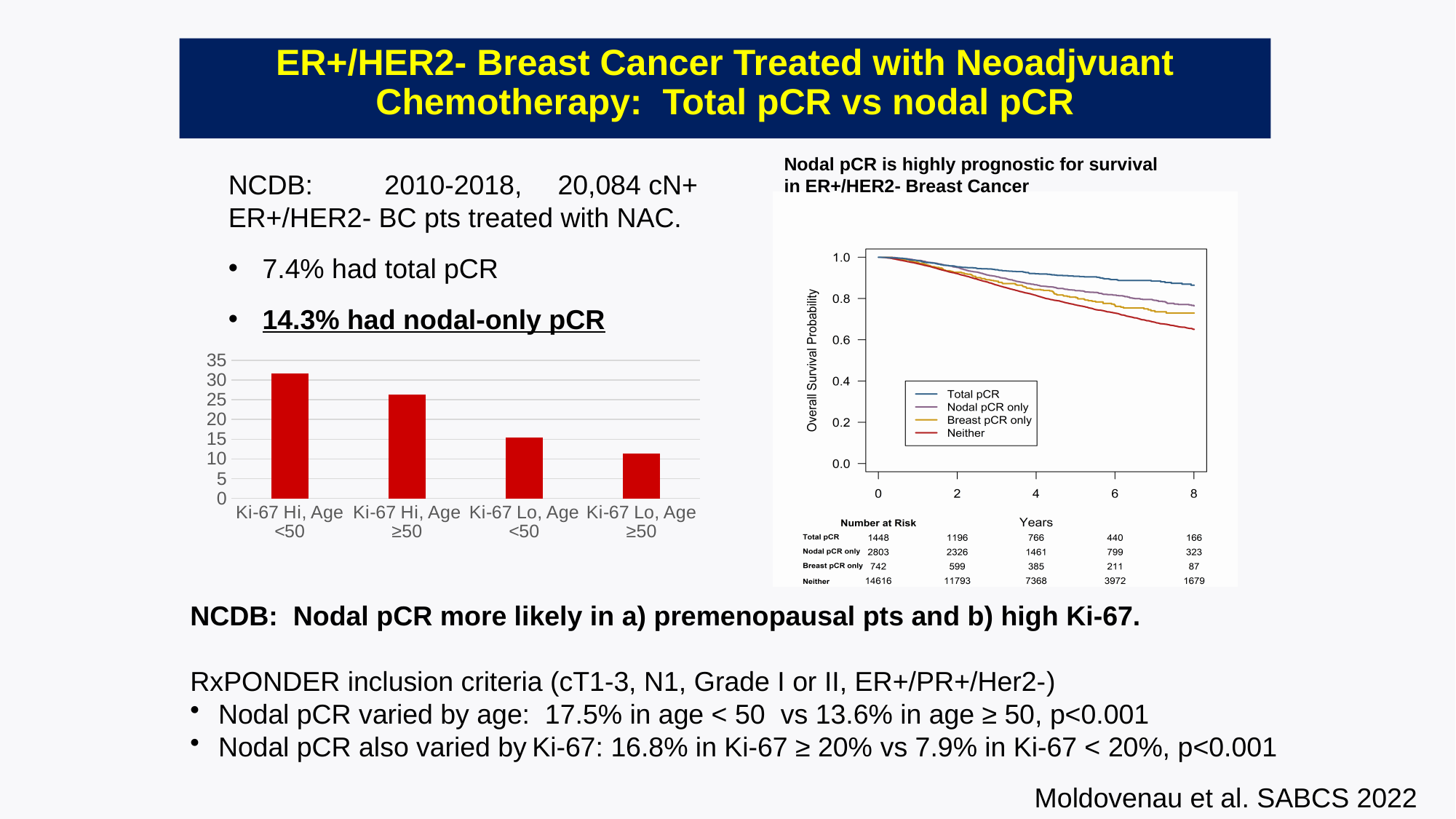
What kind of chart is the chart on the left of the slide? bar chart In the bar chart on the left, which category has the highest bar? Ki-67 Hi, Age <50 In the bar chart on the left, which category has the lowest bar? Ki-67 Lo, Age ≥50 In the survival chart on the right, what is the number at risk for the Nodal pCR only group at year 0? 2803 In the bar chart on the left, is the value for Ki-67 Hi, Age ≥50 greater or less than 30? less In the survival chart on the right, which group has the highest overall survival probability at 8 years? Total pCR In the survival chart titled 'Nodal pCR is highly prognostic for survival in ER+/HER2- Breast Cancer', how many series does the legend list? 4 In the survival chart on the right, what is the number at risk for the Neither group at year 8? 1679 In the bar chart on the left, how many categories are shown? 4 In the survival chart on the right, which group has the lowest overall survival probability at 8 years? Neither In the bar chart on the left, which is larger, the bar for Ki-67 Hi, Age ≥50 or the bar for Ki-67 Lo, Age <50? Ki-67 Hi, Age ≥50 In the bar chart on the left, is the value for Ki-67 Lo, Age <50 greater or less than 20? less